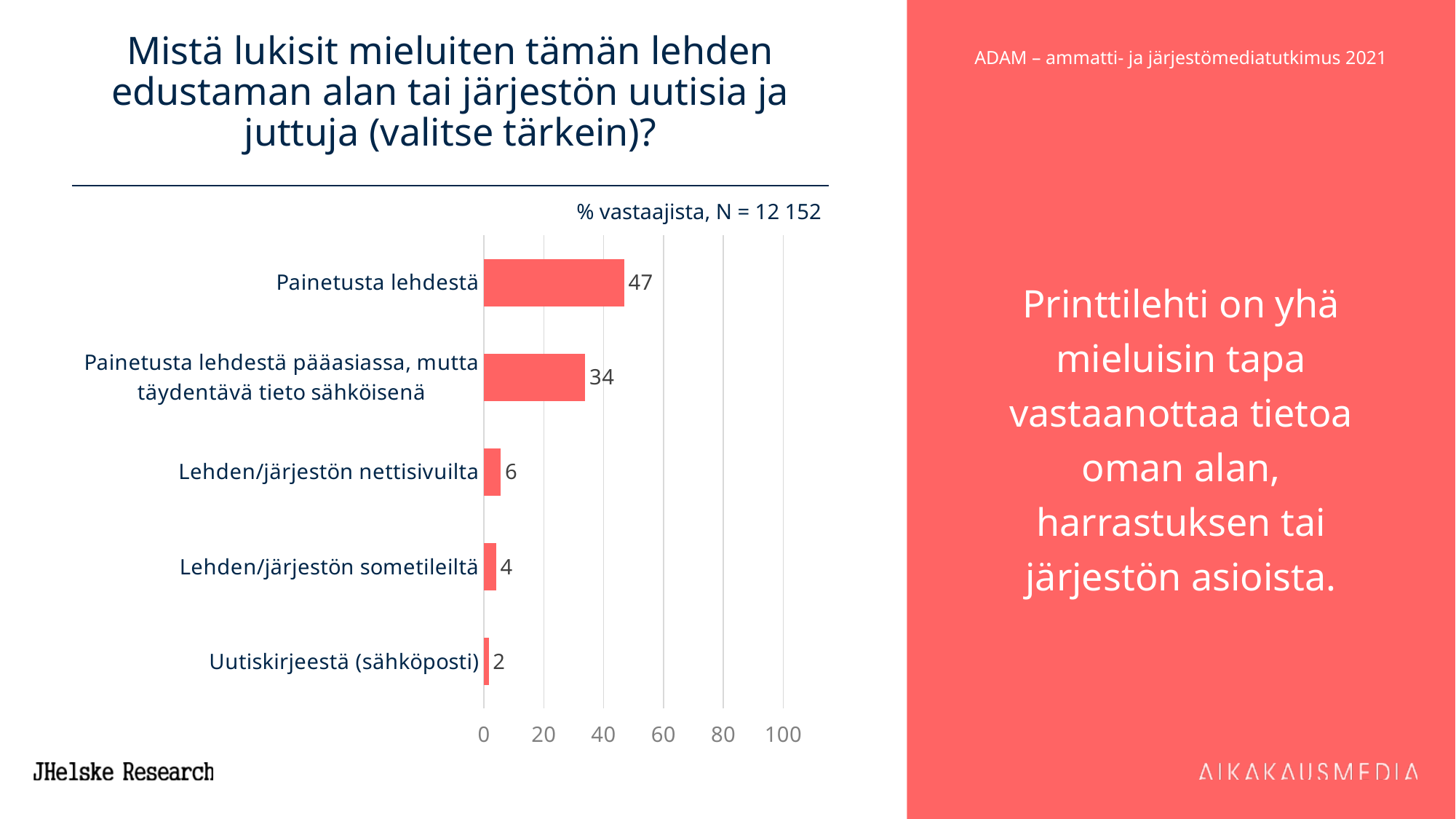
Which category has the lowest value? Uutiskirjeestä (sähköposti) Which category has the highest value? Painetusta lehdestä What is the N (number of respondents) stated above the chart? 12 152 What is the difference between the values for "Painetusta lehdestä" and "Painetusta lehdestä pääasiassa, mutta täydentävä tieto sähköisenä"? 13 What is the value for "Painetusta lehdestä"? 47 Which is larger: the value for "Lehden/järjestön nettisivuilta" or "Lehden/järjestön sometileiltä"? Lehden/järjestön nettisivuilta What is the value for "Uutiskirjeestä (sähköposti)"? 2 What is the value for "Lehden/järjestön nettisivuilta"? 6 Is the value for "Painetusta lehdestä" greater or less than 40? greater What kind of chart is shown on the slide? bar chart How many categories are shown in the chart? 5 What is the value for "Painetusta lehdestä pääasiassa, mutta täydentävä tieto sähköisenä"? 34